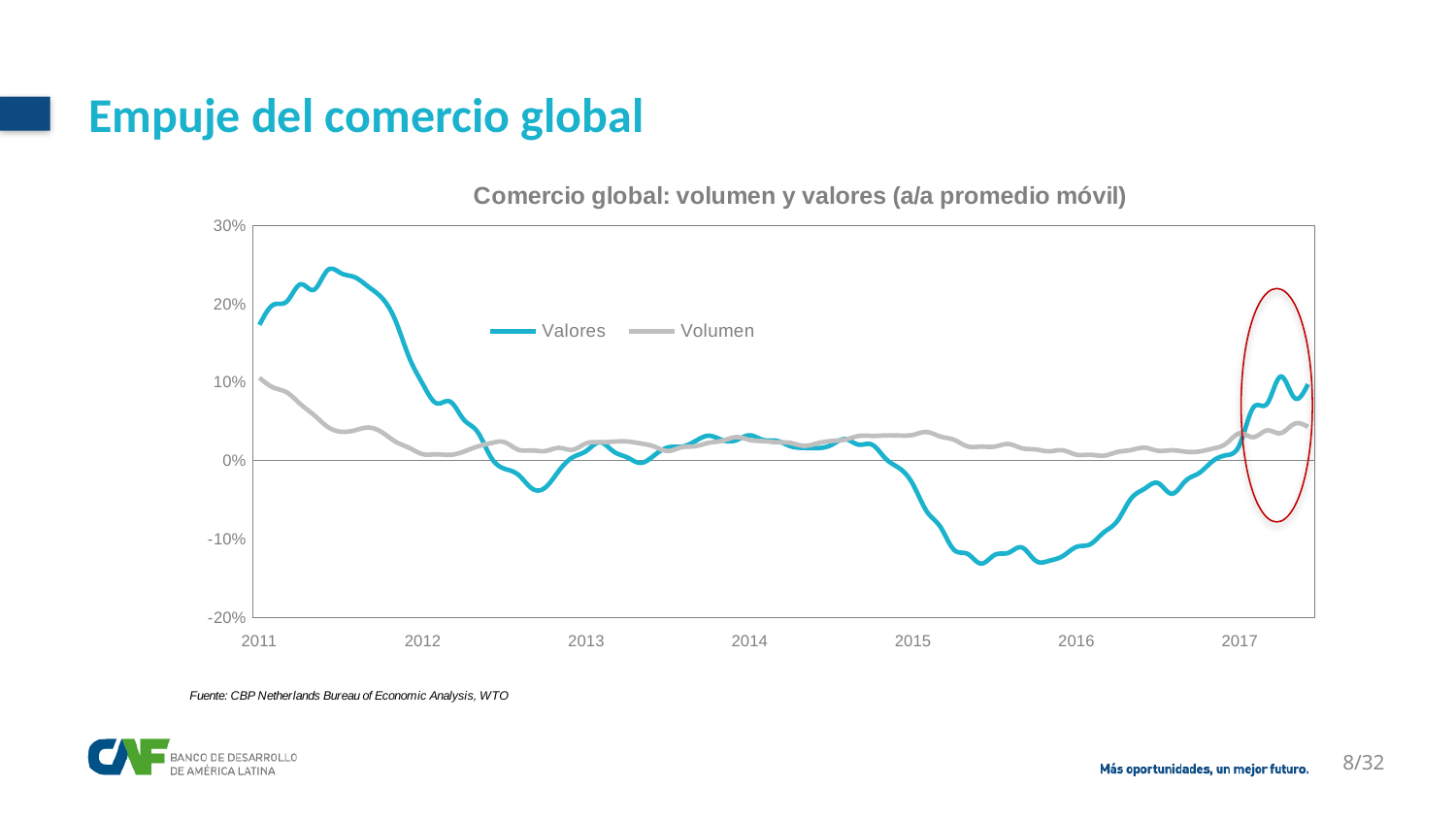
Is the lowest value of Valores in 2015 greater or less than -10%? less How many series does the legend list? 2 What are the two series named in the legend? Valores and Volumen In mid-2015, which series has the higher value, Valores or Volumen? Volumen How many year labels are shown on the x axis? 7 At the start of 2011, which series has the higher value, Valores or Volumen? Valores What kind of chart is shown on the slide? Line chart Is the value of Valores at the start of 2011 greater or less than 10%? greater Does the Valores series rise or fall between 2016 and 2017? Rises Is the peak value of Valores in 2011 greater or less than 20%? greater What is the title of the chart? Comercio global: volumen y valores (a/a promedio móvil)